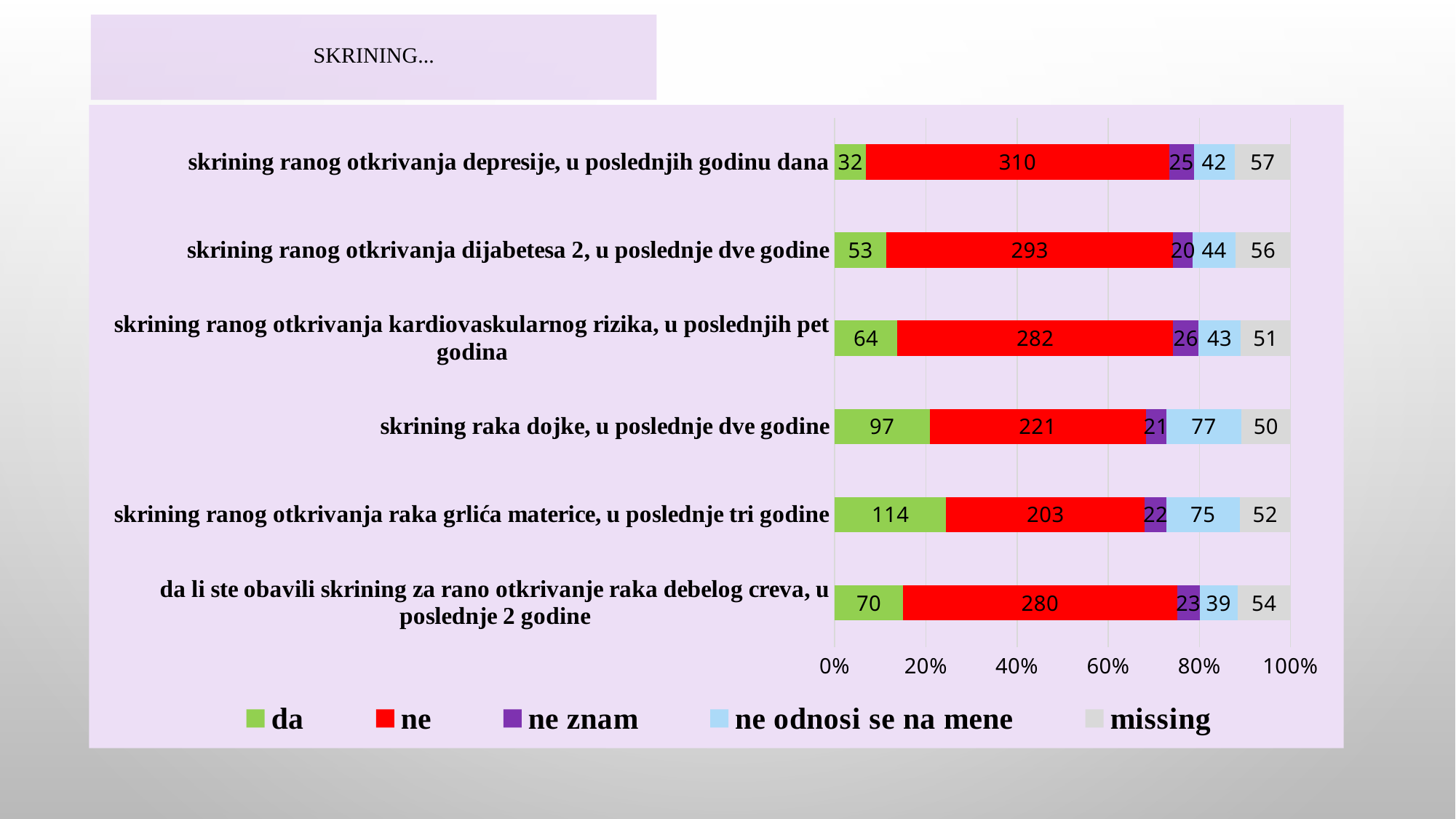
What is the total of all segments in the bar for "skrining raka dojke, u poslednje dve godine"? 466 How many series does the legend list? 5 Which category has the highest "da" value? skrining ranog otkrivanja raka grlića materice, u poslednje tri godine How many categories are shown on the chart? 6 Which category has the lowest "da" value? skrining ranog otkrivanja depresije, u poslednjih godinu dana What is the "ne odnosi se na mene" value for "da li ste obavili skrining za rano otkrivanje raka debelog creva, u poslednje 2 godine"? 39 What is the "missing" value for "skrining ranog otkrivanja dijabetesa 2, u poslednje dve godine"? 56 What kind of chart is shown on the slide? stacked bar chart What is the value of "da" for "skrining raka dojke, u poslednje dve godine"? 97 Which is larger: the "ne odnosi se na mene" value for "skrining raka dojke" or for "skrining ranog otkrivanja kardiovaskularnog rizika"? skrining raka dojke What is the value of "ne" for "skrining ranog otkrivanja depresije, u poslednjih godinu dana"? 310 What is the difference between the "ne" values for "skrining ranog otkrivanja depresije" and "skrining ranog otkrivanja raka grlića materice"? 107